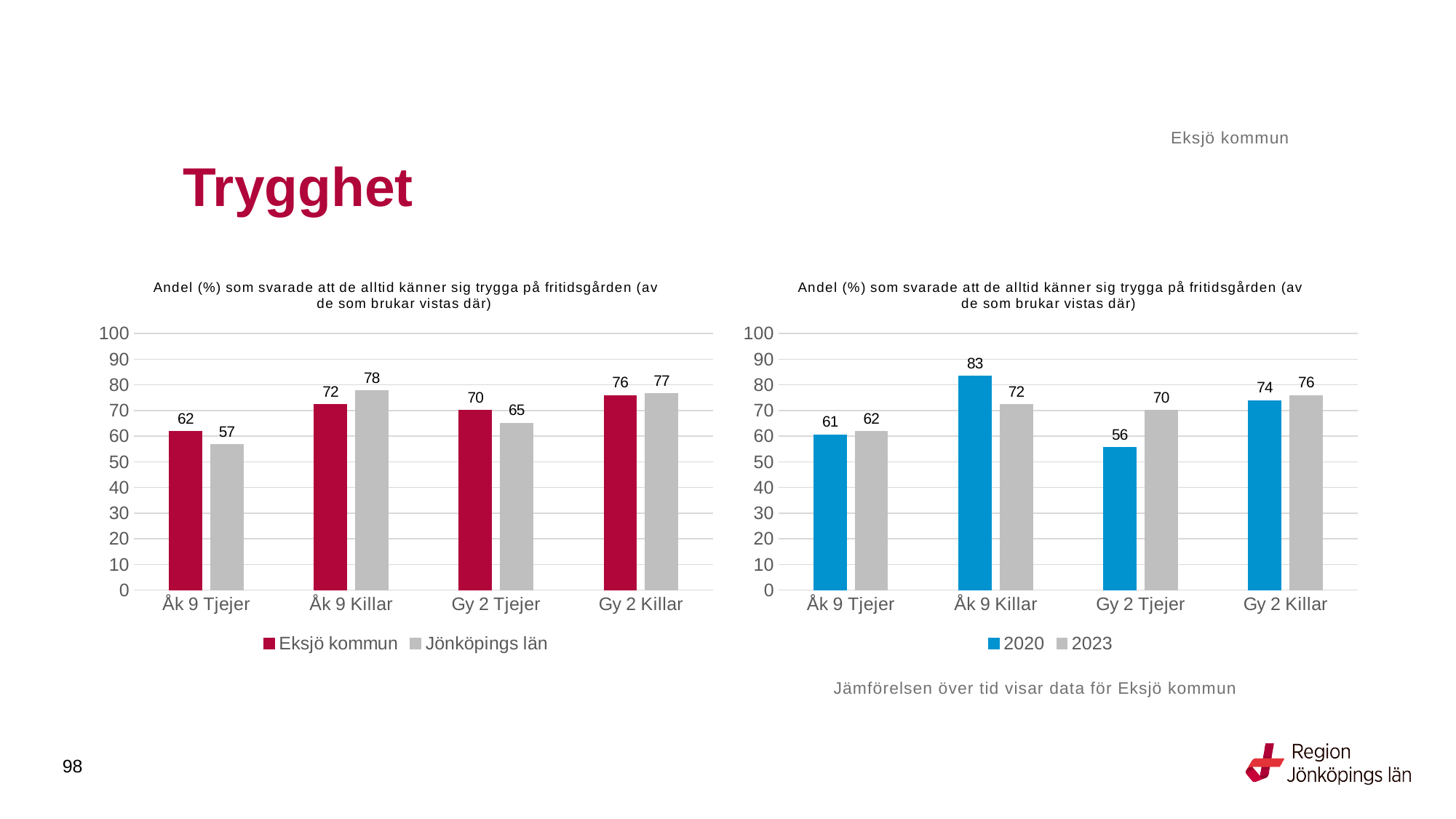
In the left chart (Eksjö kommun vs Jönköpings län), what is the value for Jönköpings län for Gy 2 Tjejer? 65 In the right chart (2020 vs 2023), what is the difference between 2020 and 2023 for Gy 2 Tjejer? 14 What kind of chart is the left chart (Eksjö kommun vs Jönköpings län)? Bar chart In the left chart (Eksjö kommun vs Jönköpings län), which is larger for Gy 2 Tjejer: Eksjö kommun or Jönköpings län? Eksjö kommun In the left chart (Eksjö kommun vs Jönköpings län), what is the difference between Eksjö kommun and Jönköpings län for Åk 9 Killar? 6 How many series does the legend of the right chart (2020 vs 2023) list? 2 In the left chart (Eksjö kommun vs Jönköpings län), which category has the lowest value for Jönköpings län? Åk 9 Tjejer In the right chart (2020 vs 2023), what is the value for 2020 for Åk 9 Killar? 83 In the left chart (Eksjö kommun vs Jönköpings län), what is the value for Eksjö kommun for Åk 9 Tjejer? 62 In the right chart (2020 vs 2023), which category has the lowest value for 2020? Gy 2 Tjejer In the left chart (Eksjö kommun vs Jönköpings län), which category has the highest value for Eksjö kommun? Gy 2 Killar In the right chart (2020 vs 2023), what is the value for 2023 for Gy 2 Tjejer? 70